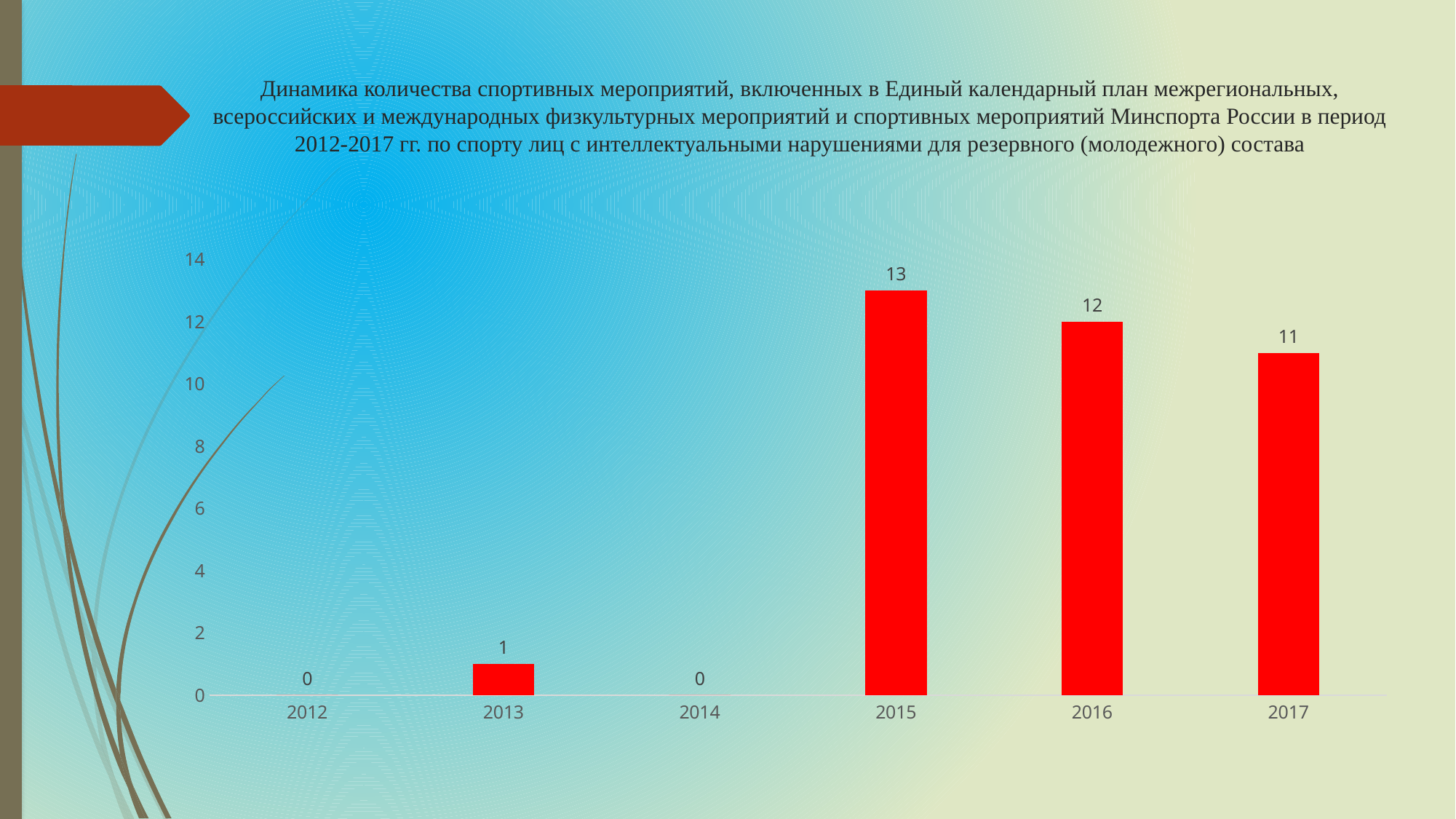
How many years are shown on the x axis? 6 What kind of chart is shown on the slide? bar chart Which is larger, the value for 2016 or the value for 2017? 2016 What is the value for 2013? 1 What is the value for 2015? 13 Which year has the highest value? 2015 What is the difference between the values for 2015 and 2017? 2 What is the value for 2017? 11 What colour are the bars in the chart? red What is the value for 2014? 0 What is the difference between the values for 2016 and 2013? 11 Is the value for 2015 greater or less than 12? greater